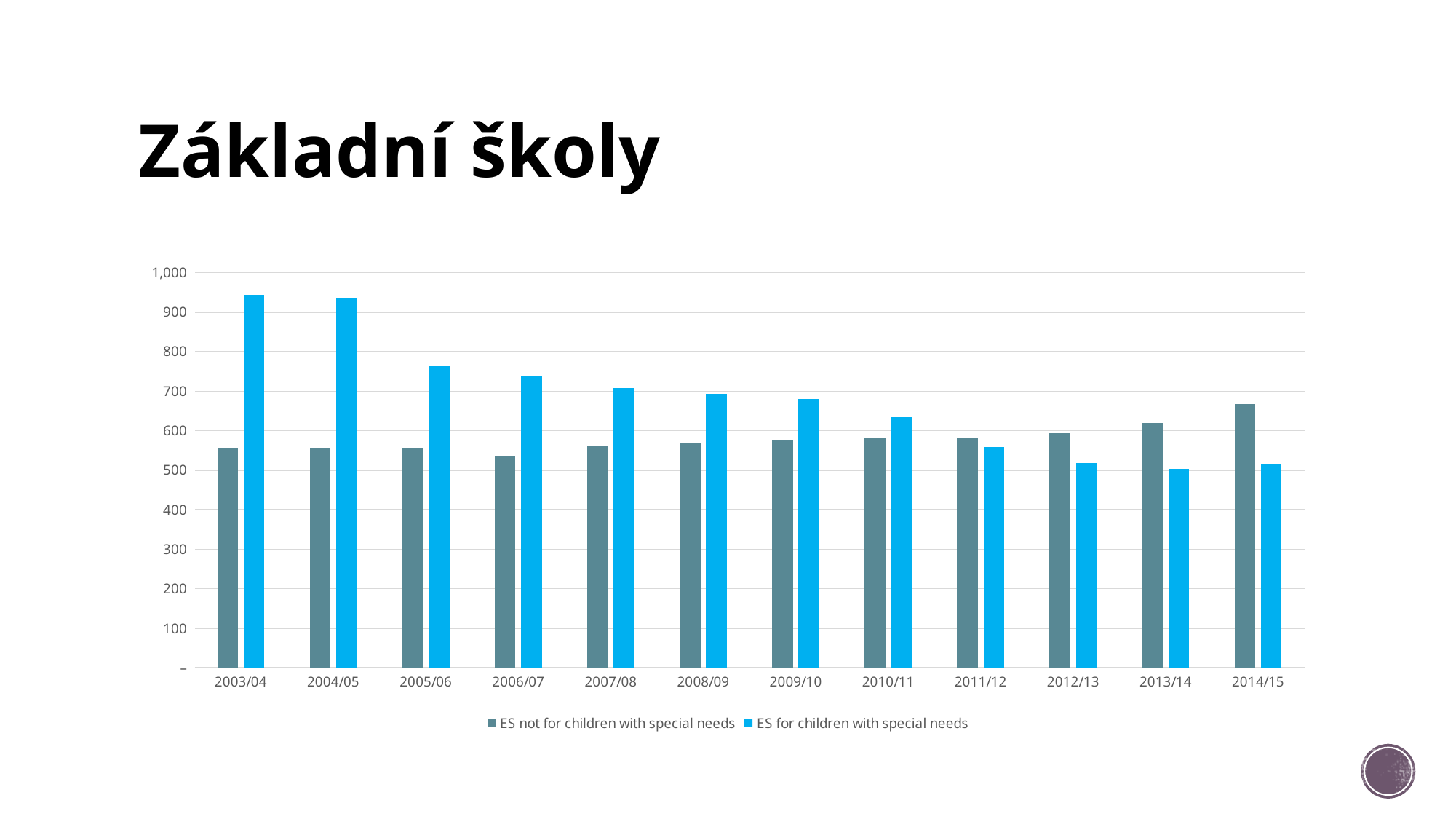
Is the value for ES for children with special needs in 2012/13 greater or less than 600? less What is the title of the slide containing the chart? Základní školy Which school year has the lowest value for ES not for children with special needs? 2006/07 How many school years are shown on the x axis? 12 In 2003/04, which series has the larger value: ES not for children with special needs or ES for children with special needs? ES for children with special needs Do the values for ES for children with special needs generally rise or fall from 2003/04 to 2014/15? fall Is the value for ES for children with special needs in 2003/04 greater or less than 900? greater How many series does the legend list? 2 Is the value for ES not for children with special needs in 2014/15 greater or less than 600? greater In 2014/15, which series has the larger value: ES not for children with special needs or ES for children with special needs? ES not for children with special needs Which school year has the highest value for ES not for children with special needs? 2014/15 What kind of chart is shown on the slide? bar chart